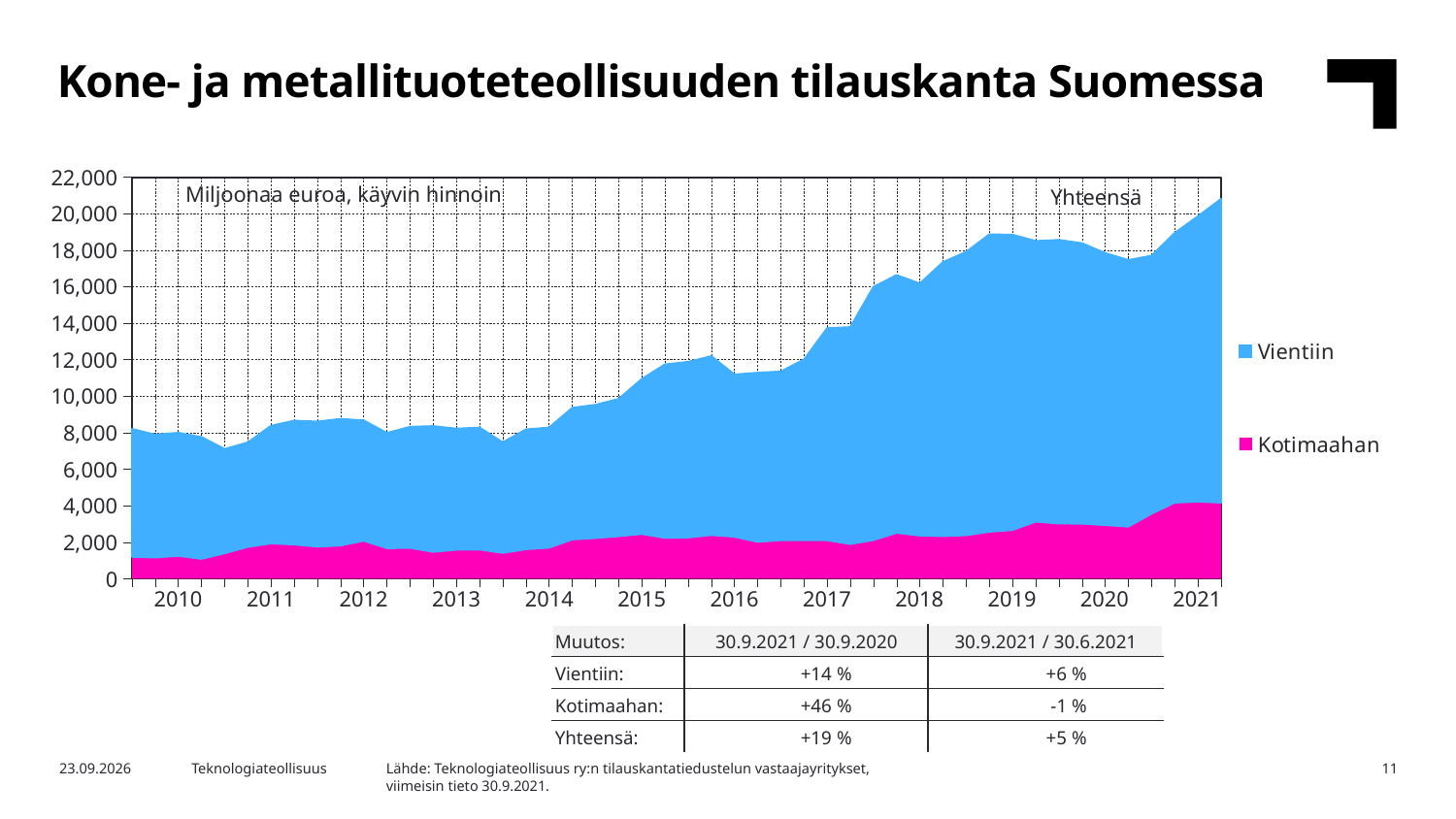
Is the Kotimaahan value at the end of 2021 greater or less than 3,000? greater At the end of 2021, which series is larger, Vientiin or Kotimaahan? Vientiin Is the total value at the start of 2010 greater or less than 10,000? less How many series does the chart legend list? 2 In which year does the total (Yhteensä) reach its highest level? 2021 Does the total order backlog (Yhteensä) generally rise or fall from 2010 to 2021? Rise Is the total value at the end of 2021 greater or less than 20,000? greater What kind of chart is shown on the slide? Stacked area chart Which two series are listed in the chart legend? Vientiin and Kotimaahan How many years are labelled on the x axis of the chart? 12 What unit is stated in the label at the top left of the chart area? Miljoonaa euroa, käyvin hinnoin